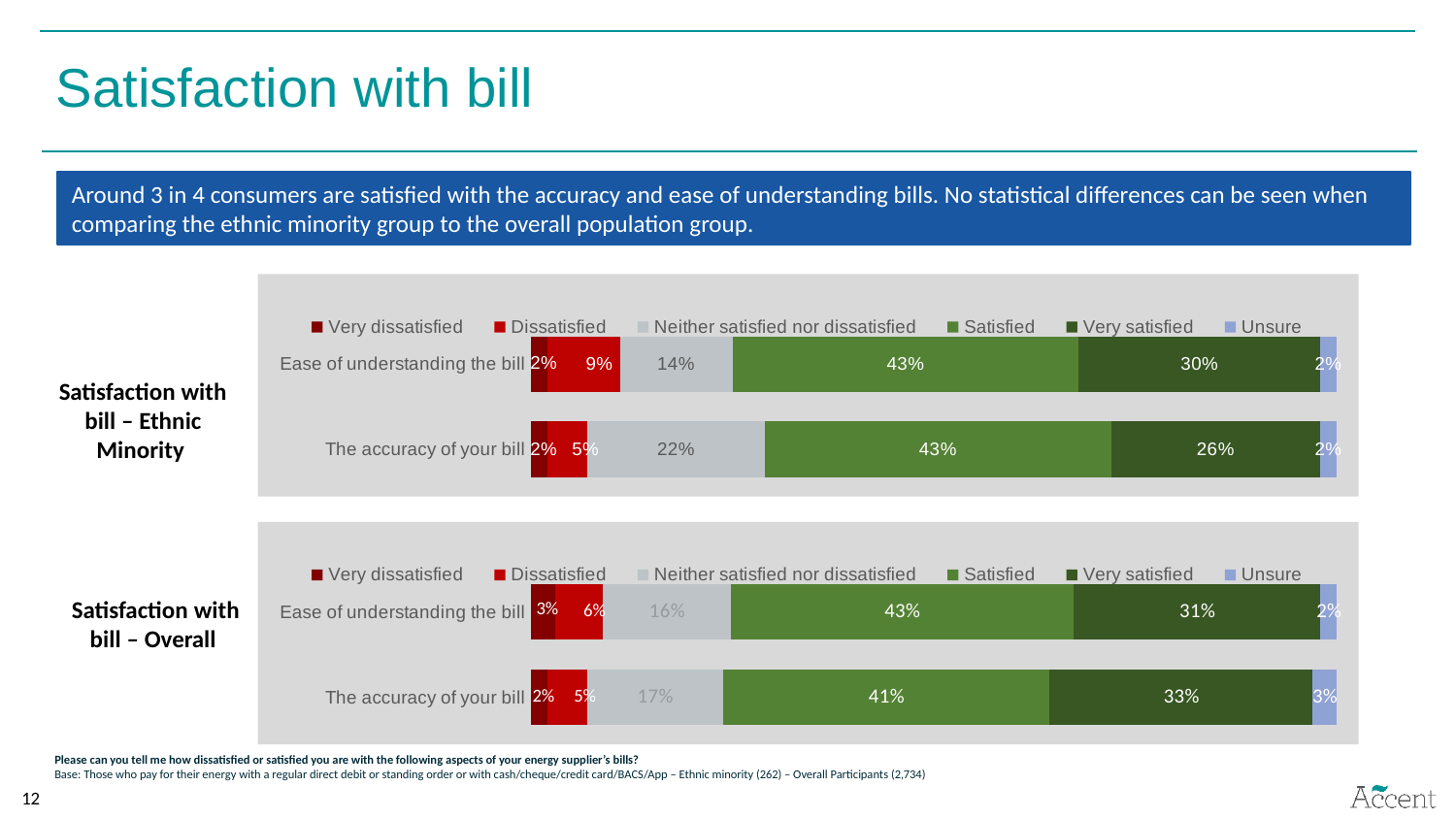
In the Satisfaction with bill – Ethnic Minority chart, which legend entry is shown in the lightest blue colour? Unsure In the Satisfaction with bill – Ethnic Minority chart, what is the difference between the Very satisfied percentages for ease of understanding the bill and the accuracy of your bill? 4% How many categories are shown in the Satisfaction with bill – Ethnic Minority chart? 2 In the Satisfaction with bill – Overall chart, what is the difference between the Neither satisfied nor dissatisfied percentages for ease of understanding the bill and the accuracy of your bill? 1% How many series does the legend list in the Satisfaction with bill – Overall chart? 6 In the Satisfaction with bill – Overall chart, what percentage are Dissatisfied with the ease of understanding the bill? 6% In the Satisfaction with bill – Ethnic Minority chart, what percentage are Neither satisfied nor dissatisfied with the accuracy of their bill? 22% In the Satisfaction with bill – Overall chart, which category has the larger Satisfied percentage: ease of understanding the bill or the accuracy of your bill? Ease of understanding the bill In the Satisfaction with bill – Overall chart, what percentage are Very satisfied with the accuracy of their bill? 33% What kind of chart is the Satisfaction with bill – Overall chart? Stacked bar chart In the Satisfaction with bill – Ethnic Minority chart, which category has the larger Dissatisfied percentage? Ease of understanding the bill In the Satisfaction with bill – Ethnic Minority chart, what percentage are Satisfied with the ease of understanding the bill? 43%